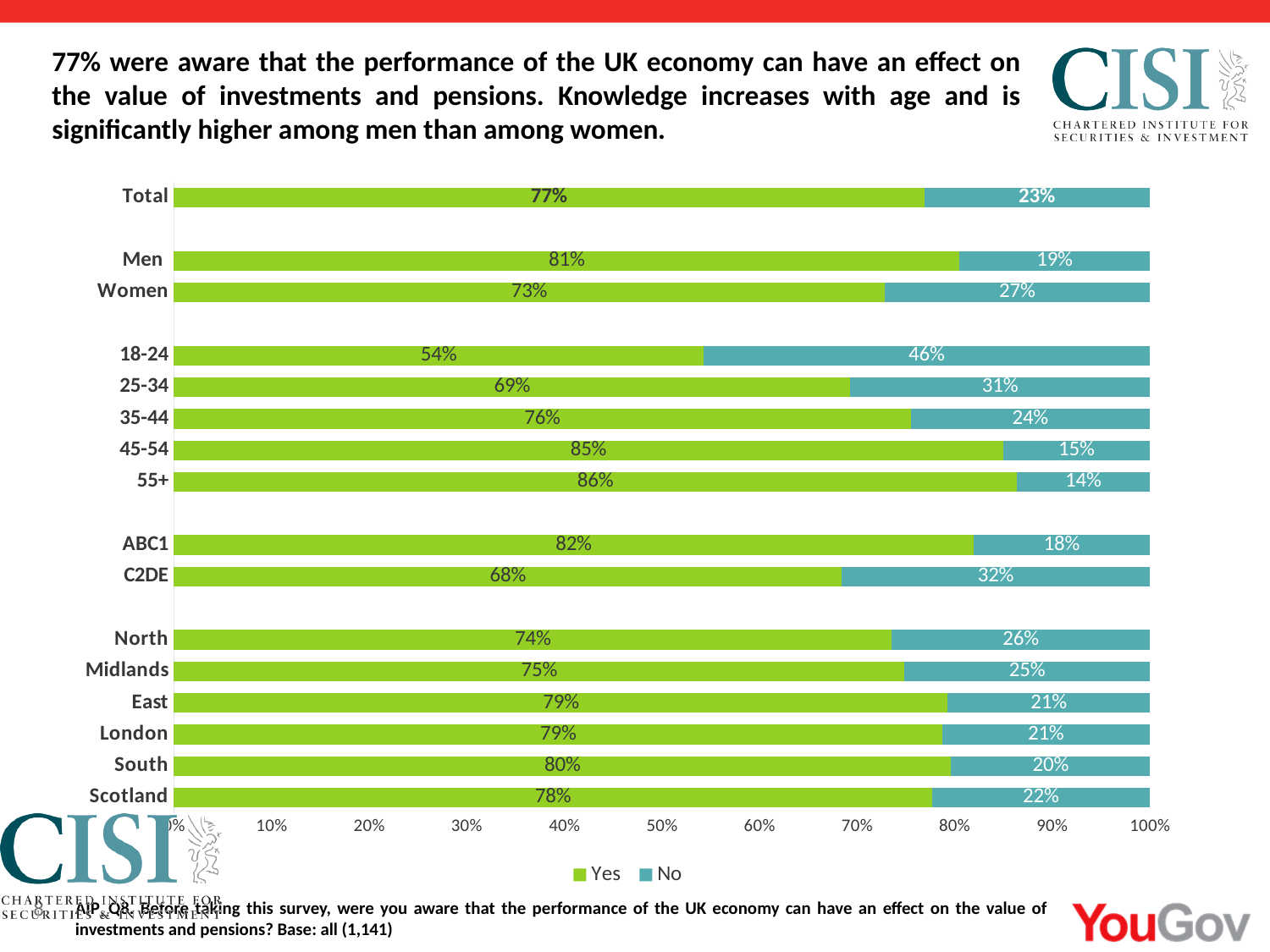
Which has a larger Yes value, ABC1 or C2DE? ABC1 Do the Yes values rise or fall as age increases from 18-24 to 55+? Rise What is the total of the Yes and No segments for the 45-54 bar? 100% What is the difference between the Yes values for Men and Women? 8% How many series does the legend list? 2 What is the Yes value for Scotland? 78% What colour represents the No series? Teal Which age group has the highest Yes value? 55+ What percentage of the Total answered Yes? 77% What kind of chart is shown? Stacked bar chart What is the No value for the 18-24 age group? 46% Which category has the lowest Yes value? 18-24